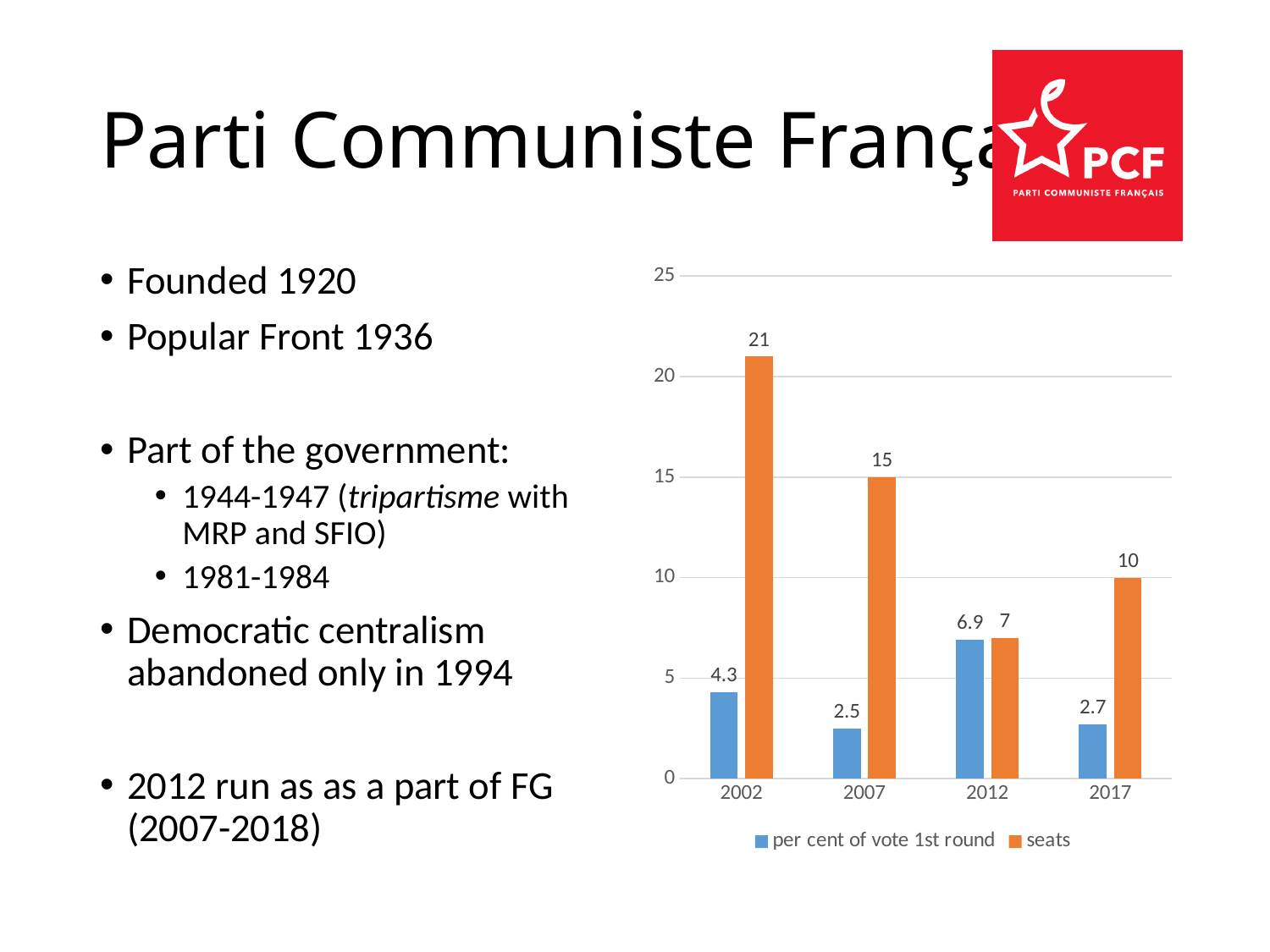
Is the number of seats for 2012 greater or less than 10? less Which colour represents the seats series in the chart? orange How many years are shown on the x axis? 4 What is the per cent of vote 1st round for 2017? 2.7 How many series does the legend list? 2 Which year has the highest number of seats? 2002 What kind of chart is shown on the slide? bar chart What is the difference in seats between 2002 and 2017? 11 What is the per cent of vote 1st round for 2002? 4.3 Which is larger: the per cent of vote 1st round in 2012 or in 2002? 2012 How many seats are shown for 2007? 15 Which year has the lowest per cent of vote 1st round? 2007